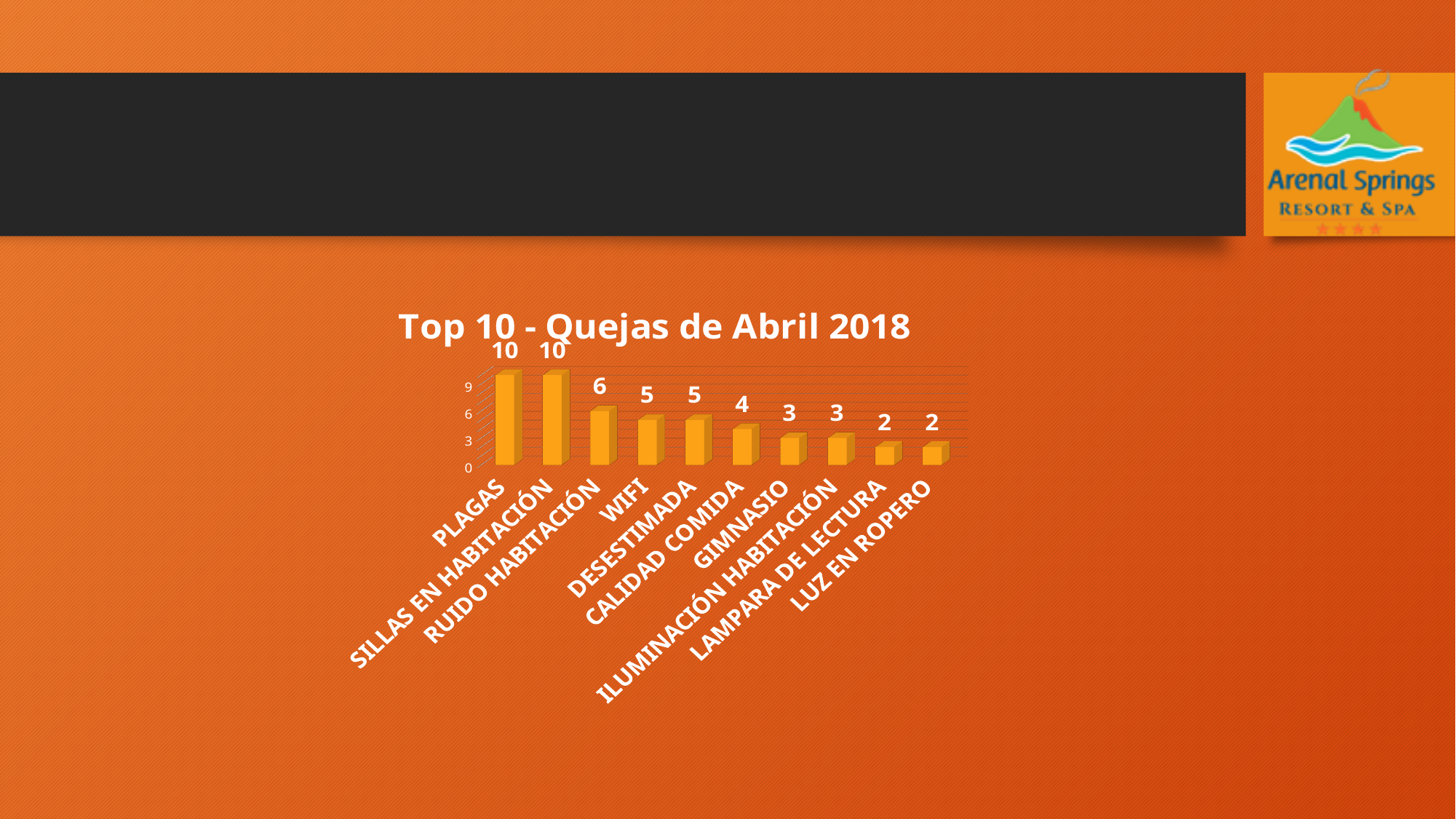
What type of chart is shown on the slide? bar chart What is the value for WIFI? 5 Which is larger, the value for WIFI or the value for GIMNASIO? WIFI What is the value for CALIDAD COMIDA? 4 Do the values rise or fall from left to right along the x axis? fall What is the value for RUIDO HABITACIÓN? 6 What is the value for LUZ EN ROPERO? 2 What is the value for GIMNASIO? 3 What is the value for PLAGAS? 10 How many categories are plotted in the chart? 10 What is the difference between the values for PLAGAS and RUIDO HABITACIÓN? 4 What is the title of the chart? Top 10 - Quejas de Abril 2018